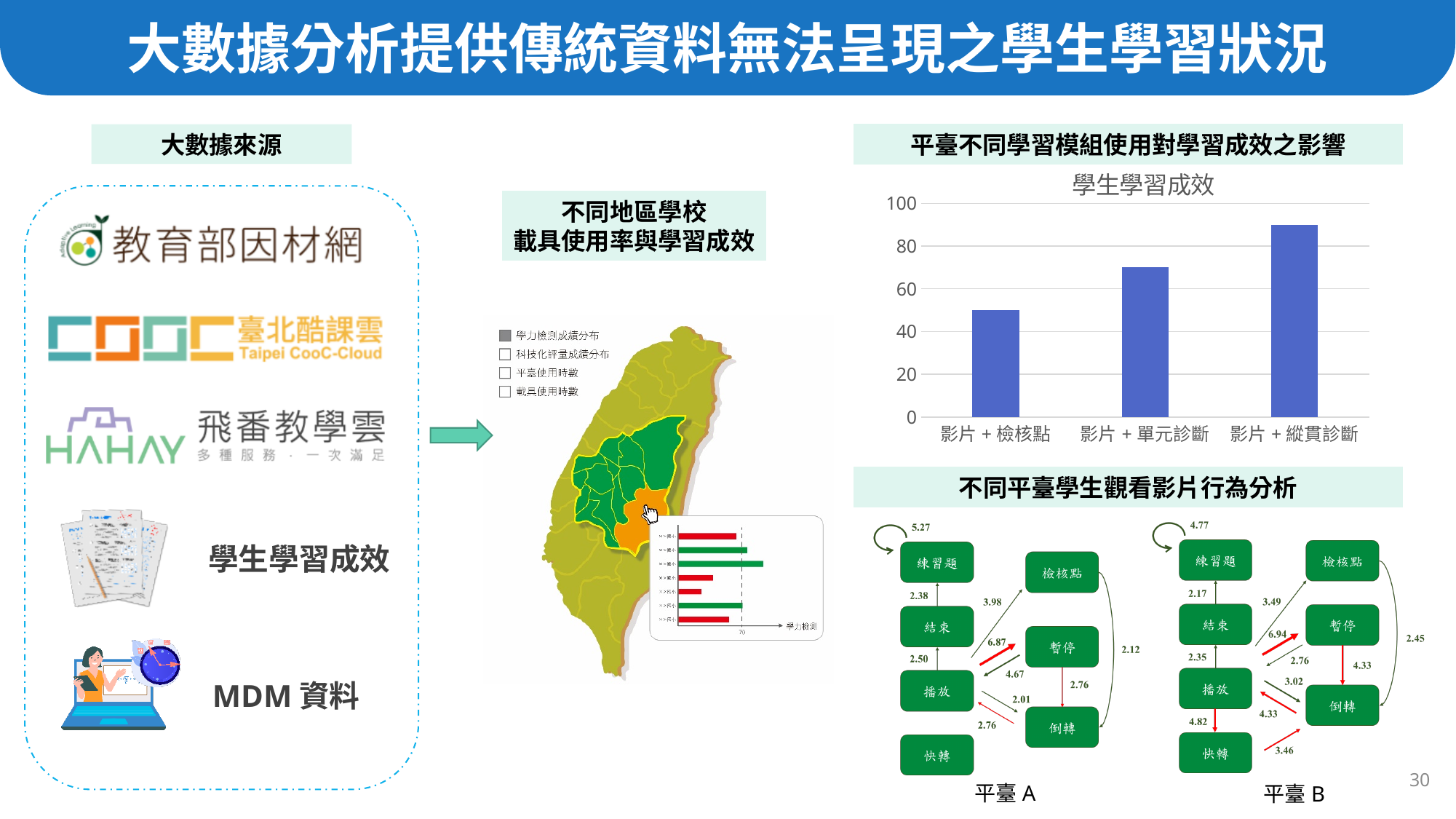
In the chart titled 學生學習成效, which is larger, the value for 影片＋單元診斷 or the value for 影片＋縱貫診斷? 影片＋縱貫診斷 In the chart titled 學生學習成效, is the value for 影片＋單元診斷 greater or less than 60? greater What is the maximum value shown on the y axis of the chart titled 學生學習成效? 100 In the chart titled 學生學習成效, is the value for 影片＋檢核點 greater or less than 60? less In the chart titled 學生學習成效, how many categories are shown on the x axis? 3 What kind of chart is the chart titled 學生學習成效? bar chart In the chart titled 學生學習成效, is the value for 影片＋縱貫診斷 greater or less than 80? greater In the chart titled 學生學習成效, which category has the lowest value? 影片＋檢核點 What is the title of the bar chart on the right side of the slide? 學生學習成效 In the chart titled 學生學習成效, do the values rise or fall from left to right along the x axis? rise In the chart titled 學生學習成效, which category has the highest value? 影片＋縱貫診斷